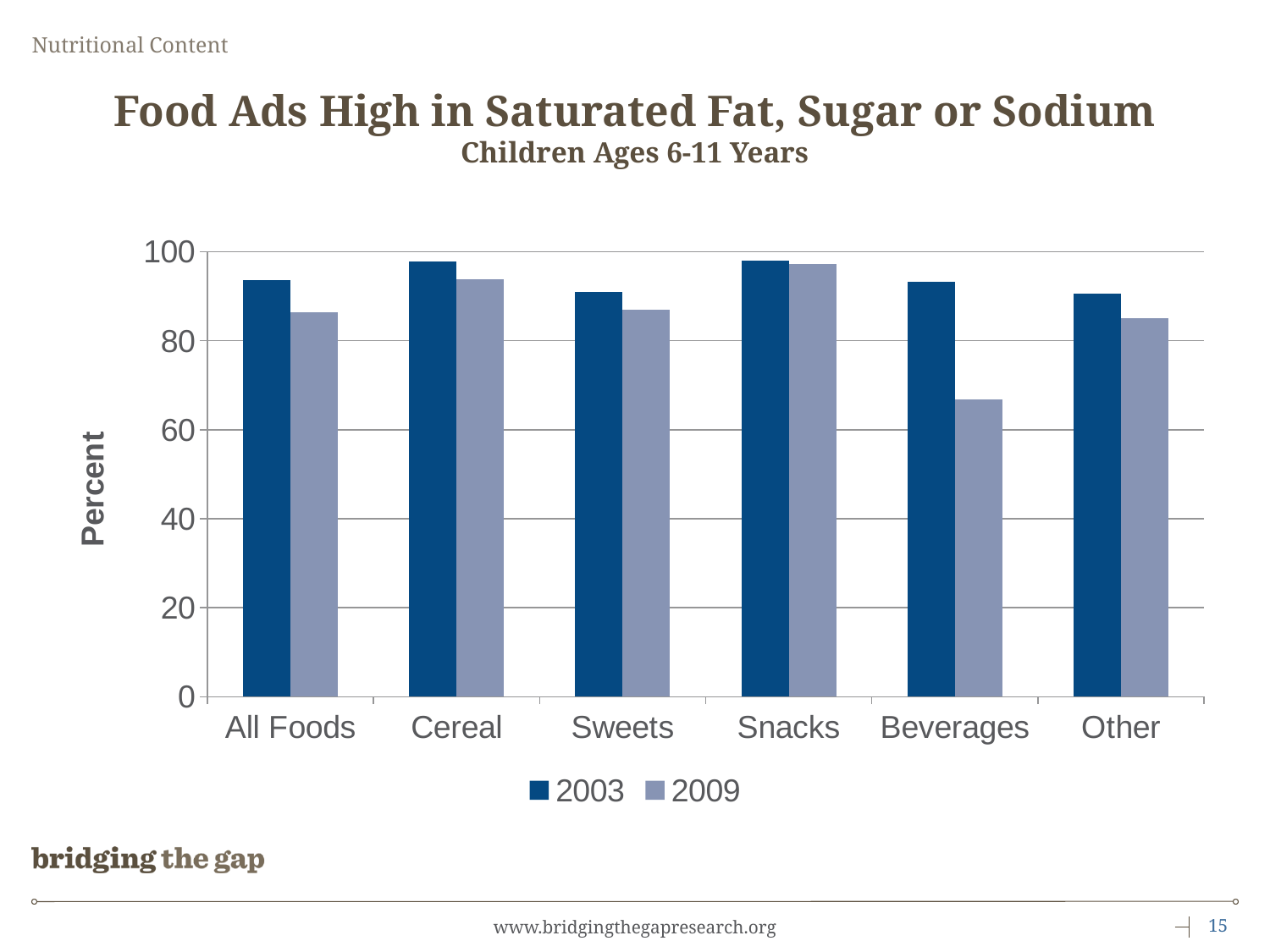
Is the 2009 value for All Foods greater or less than 80? greater How many food categories are shown on the x axis? 6 What is the subtitle of the chart, below the main title? Children Ages 6-11 Years Is the 2009 value for Beverages greater or less than 60? greater For Beverages, which year has the larger value, 2003 or 2009? 2003 Which is larger, the 2009 value for Cereal or the 2009 value for Beverages? Cereal Is the 2003 value for Cereal greater or less than 80? greater What is the label on the y axis? Percent What kind of chart is shown on the slide? bar chart How many series does the legend list? 2 Which category has the lowest value for 2009? Beverages